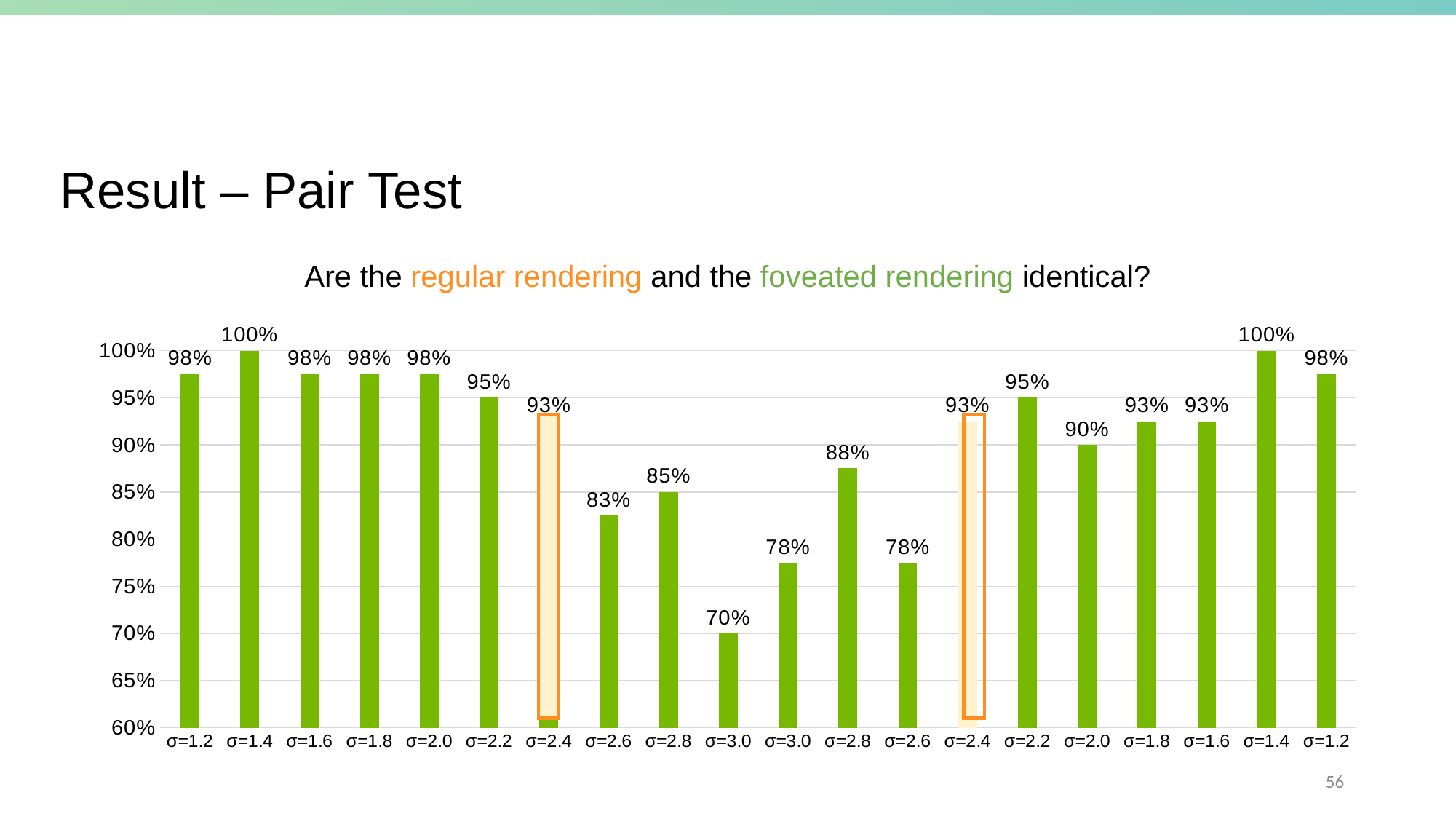
What is the lowest value shown in the chart? 70% Which two bars are highlighted with an orange outline? the two σ=2.4 bars How many bars are plotted in the chart? 20 What type of chart is shown on the slide? bar chart What is the value of the bar labelled σ=2.8 on the right half of the chart (the twelfth bar from the left)? 88% What is the difference between the value of the second bar (σ=1.4, 100%) and the tenth bar (σ=3.0, 70%)? 30% What is the highest value shown in the chart? 100% Which is larger: the value of the ninth bar (σ=2.8, left half) or the twelfth bar (σ=2.8, right half)? the twelfth bar (σ=2.8, right half) What is the value of the bar labelled σ=2.0 on the right half of the chart (the sixteenth bar from the left)? 90% What is the value of the bar labelled σ=2.6 on the left half of the chart (the eighth bar from the left)? 83% Is the value of the tenth bar (σ=3.0, left half) greater or less than 75%? less What is the value of the leftmost bar (σ=1.2)? 98%